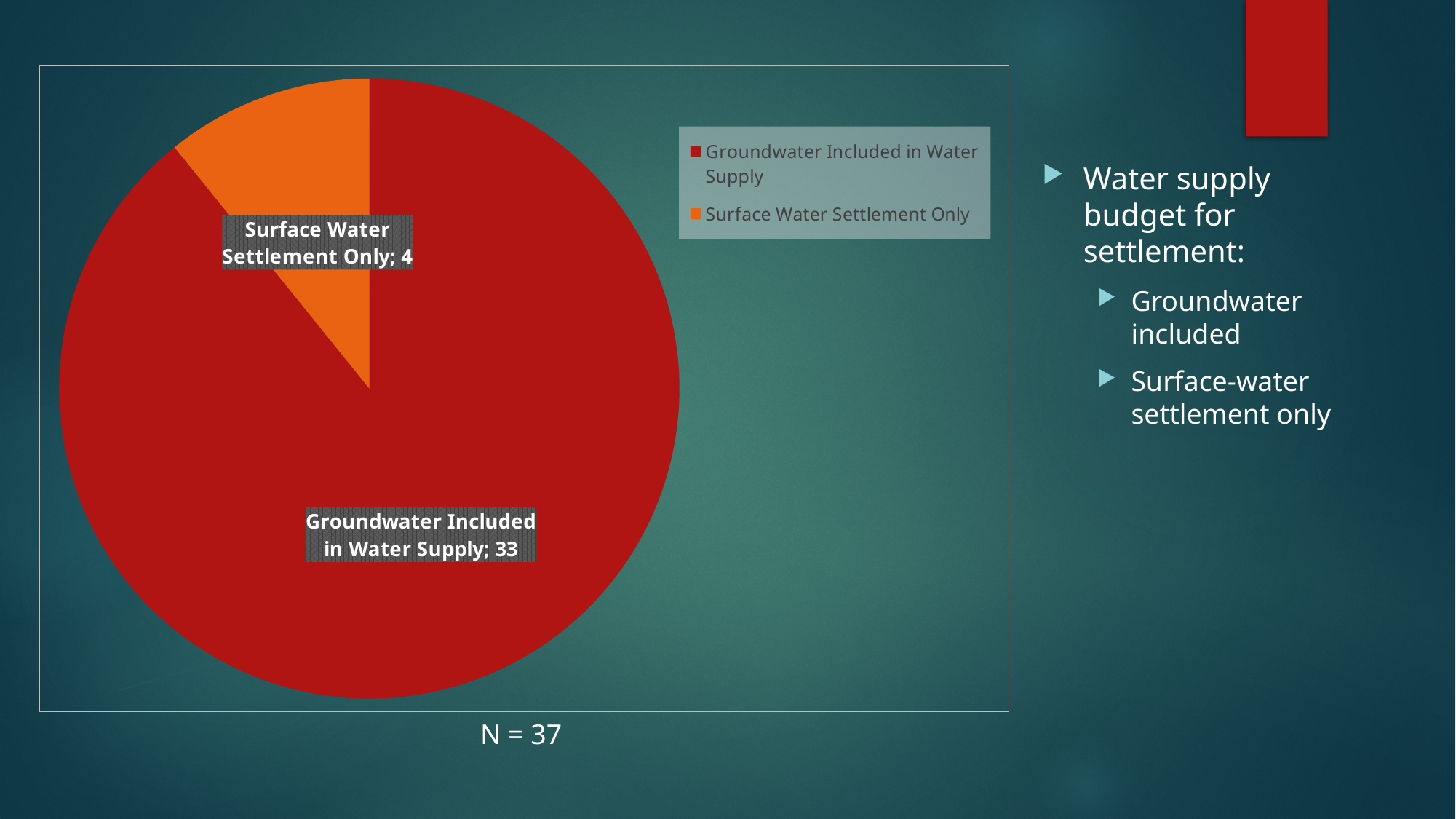
Which is larger: Groundwater Included in Water Supply or Surface Water Settlement Only? Groundwater Included in Water Supply Which category has the largest slice of the pie? Groundwater Included in Water Supply What is the N value printed below the chart? N = 37 What kind of chart is shown on the slide? pie chart How many entries does the legend list? 2 What is the value for Groundwater Included in Water Supply? 33 How many slices does the pie chart have? 2 What is the value for Surface Water Settlement Only? 4 What is the difference between the values for Groundwater Included in Water Supply and Surface Water Settlement Only? 29 Which category has the smallest slice of the pie? Surface Water Settlement Only What is the total of the two slices in the pie chart? 37 What colour is the Surface Water Settlement Only slice? orange